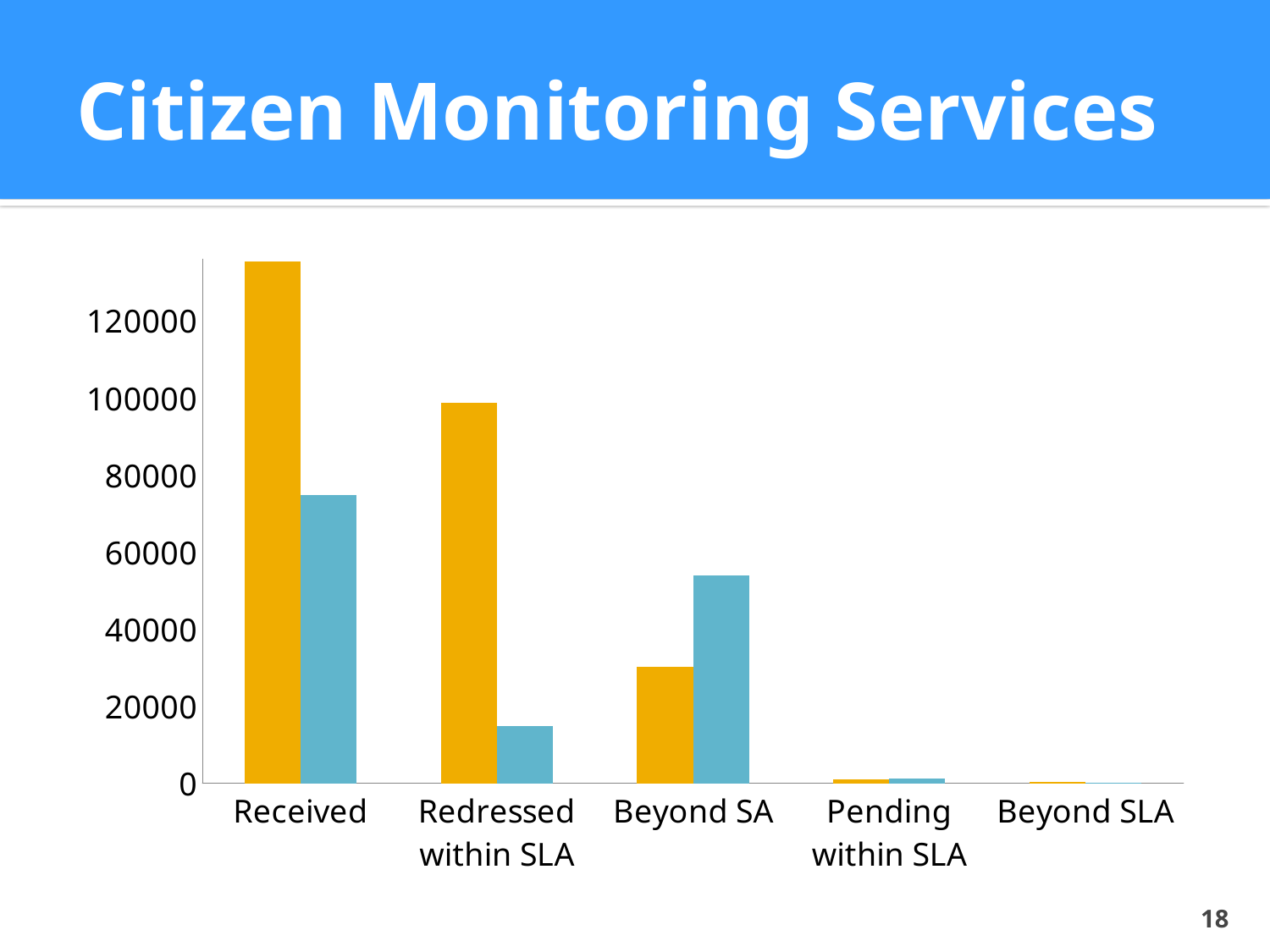
Which category has the tallest orange bar? Received Is the orange bar for Received greater or less than 120000? greater How many categories are shown on the x axis of the chart? 5 Is the orange bar for Beyond SA greater or less than 40000? less What kind of chart is shown on the slide? bar chart Do the orange bars rise or fall from left to right across the categories? fall Which category has the tallest blue bar? Received Is the blue bar for Received greater or less than 80000? less For Beyond SA, which bar is taller, the orange one or the blue one? the blue one